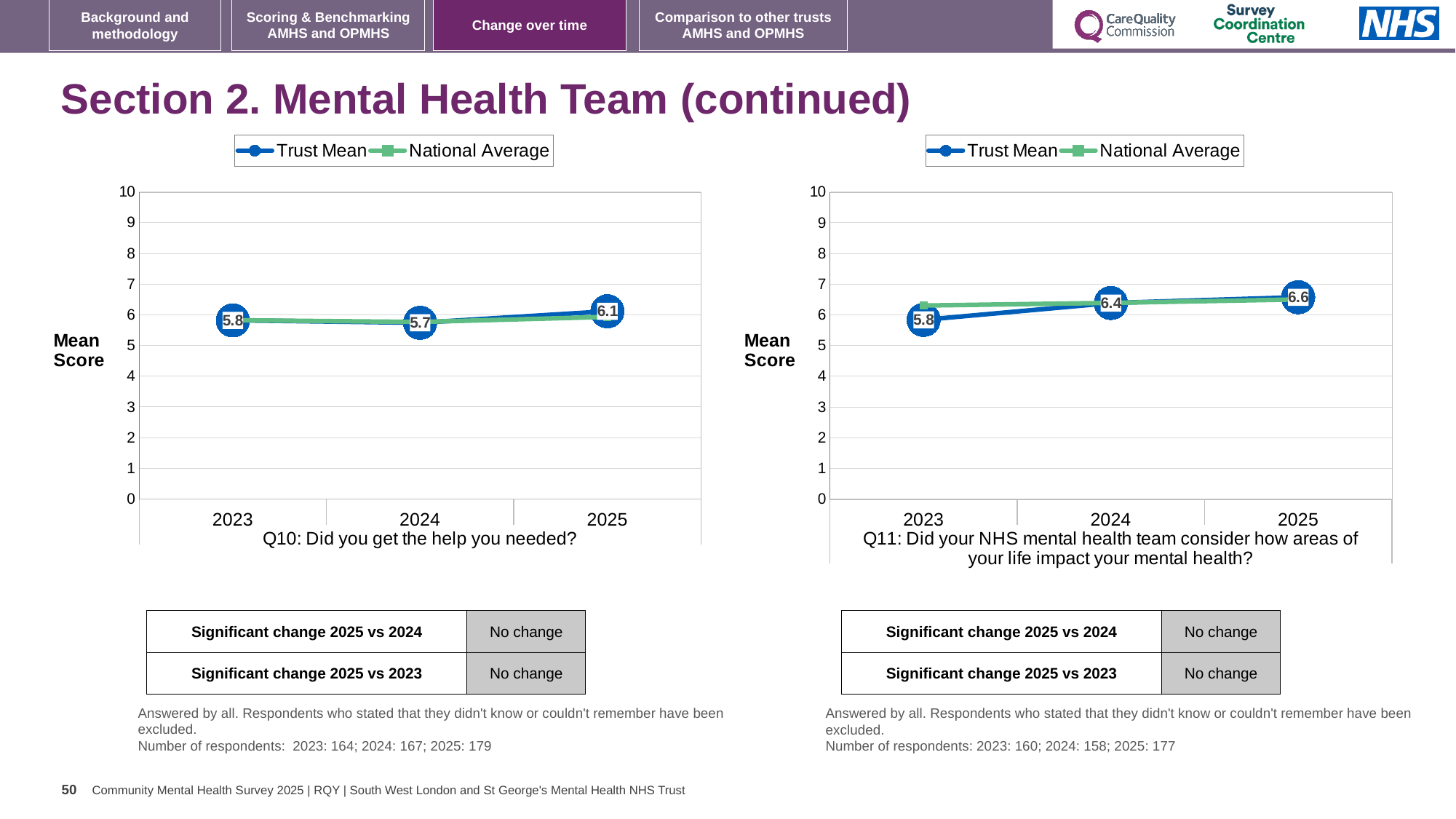
On the Q11 chart, is the National Average for 2023 greater or less than 5? greater On the Q10 chart, is the Trust Mean score for 2025 higher or lower than for 2024? higher On the Q10 chart, what is the Trust Mean score for 2025? 6.1 On the Q11 chart, what is the Trust Mean score for 2023? 5.8 How many years are plotted on the Q10 chart? 3 On the Q11 chart, what is the difference between the Trust Mean scores for 2025 and 2023? 0.8 On the Q10 chart, which year has the highest Trust Mean score? 2025 What kind of chart is used for Q11? line chart On the Q11 chart, what is the Trust Mean score for 2025? 6.6 On the Q10 chart, what is the Trust Mean score for 2024? 5.7 How many series does the legend of the Q11 chart list? 2 On the Q11 chart, which year has the lowest Trust Mean score? 2023